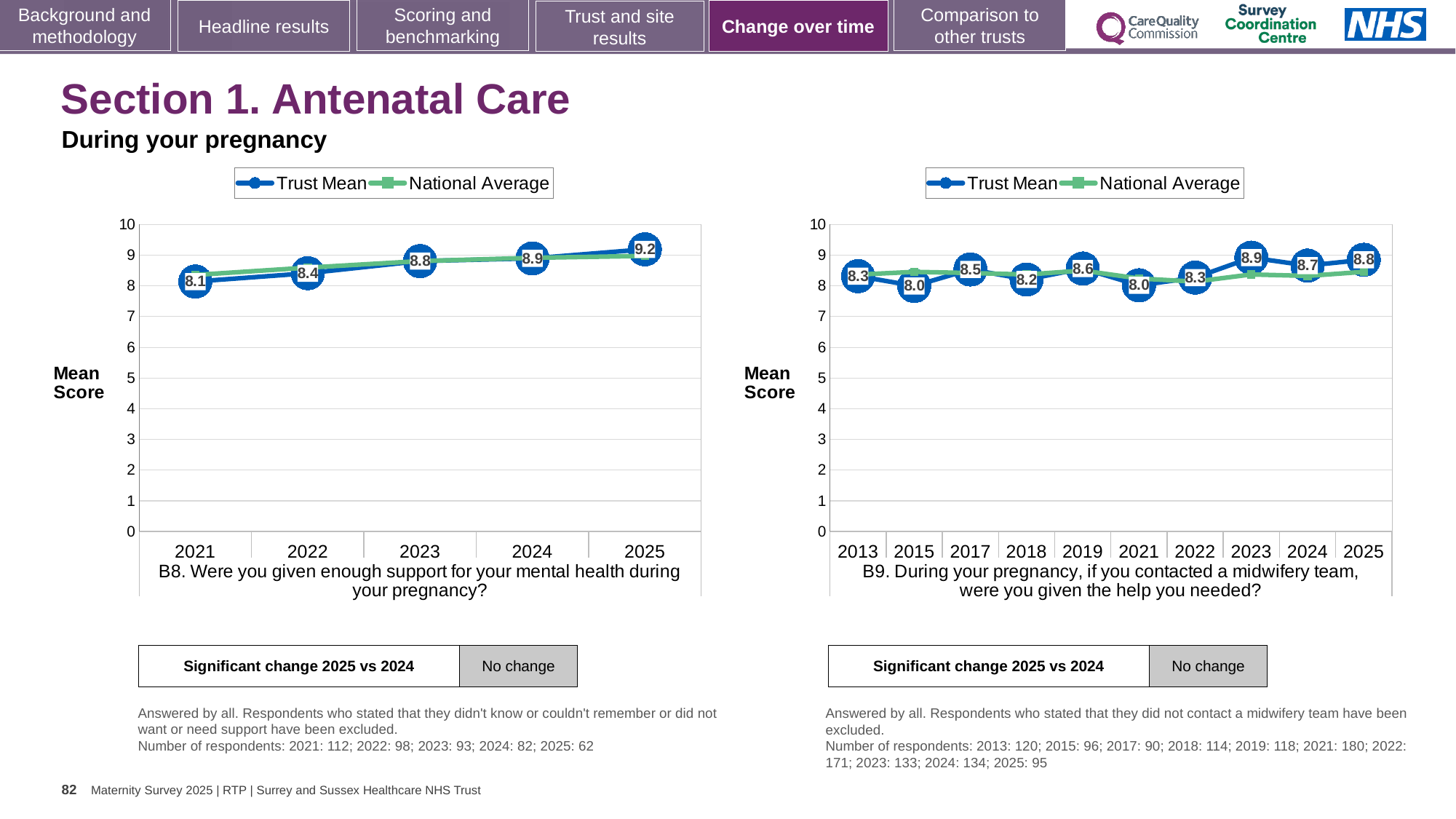
In the left chart (B8), what is the Trust Mean for 2021? 8.1 In the right chart (B9), how many years are shown on the x axis? 10 How many series does the legend of the right chart (B9) list? 2 In the left chart (B8), how many years are shown on the x axis? 5 In the left chart (B8), what is the difference between the Trust Mean in 2025 and in 2021? 1.1 In the left chart (B8), what is the Trust Mean for 2025? 9.2 In the left chart (B8), which year has the highest Trust Mean? 2025 In the right chart (B9), what is the Trust Mean for 2023? 8.9 In the left chart (B8), does the Trust Mean rise or fall from 2021 to 2025? rise In the right chart (B9), what is the Trust Mean for 2018? 8.2 In the right chart (B9), which year has the highest Trust Mean? 2023